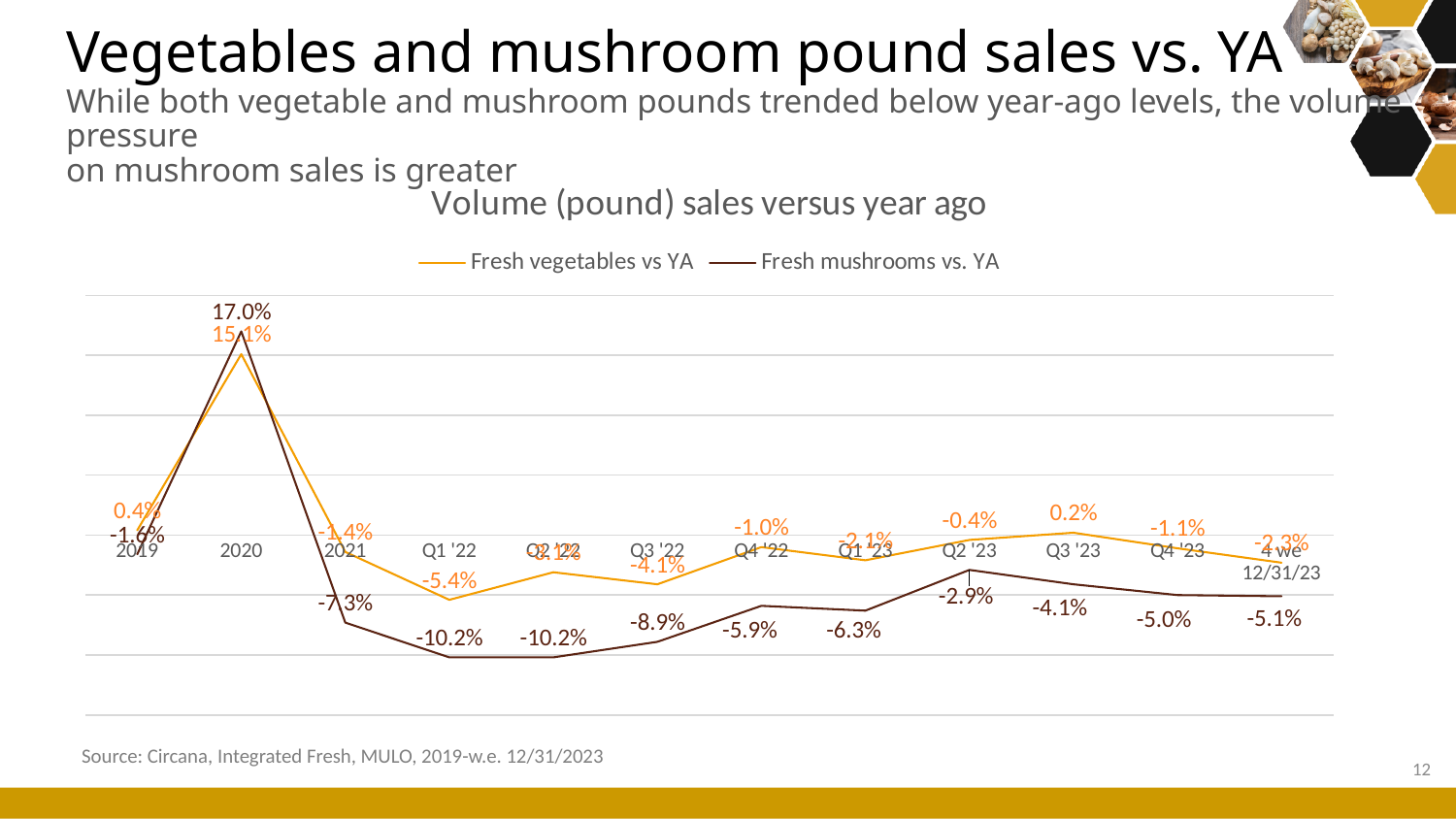
In Q3 '23, which series has the larger value, Fresh vegetables vs YA or Fresh mushrooms vs. YA? Fresh vegetables vs YA How many series does the legend list? 2 What is the value for Fresh vegetables vs YA in Q1 '22? -5.4% What is the value for Fresh vegetables vs YA in Q3 '23? 0.2% What is the title of the chart? Volume (pound) sales versus year ago What is the value for Fresh mushrooms vs. YA in Q4 '23? -5.0% In which period is the Fresh mushrooms vs. YA value highest? 2020 How many time periods are plotted along the x axis? 12 In 2020, what is the difference between the Fresh mushrooms vs. YA value and the Fresh vegetables vs YA value? 1.9 percentage points In which period is the Fresh vegetables vs YA value lowest? Q1 '22 What kind of chart is shown on the slide? Line chart What is the value for Fresh mushrooms vs. YA in 2020? 17.0%